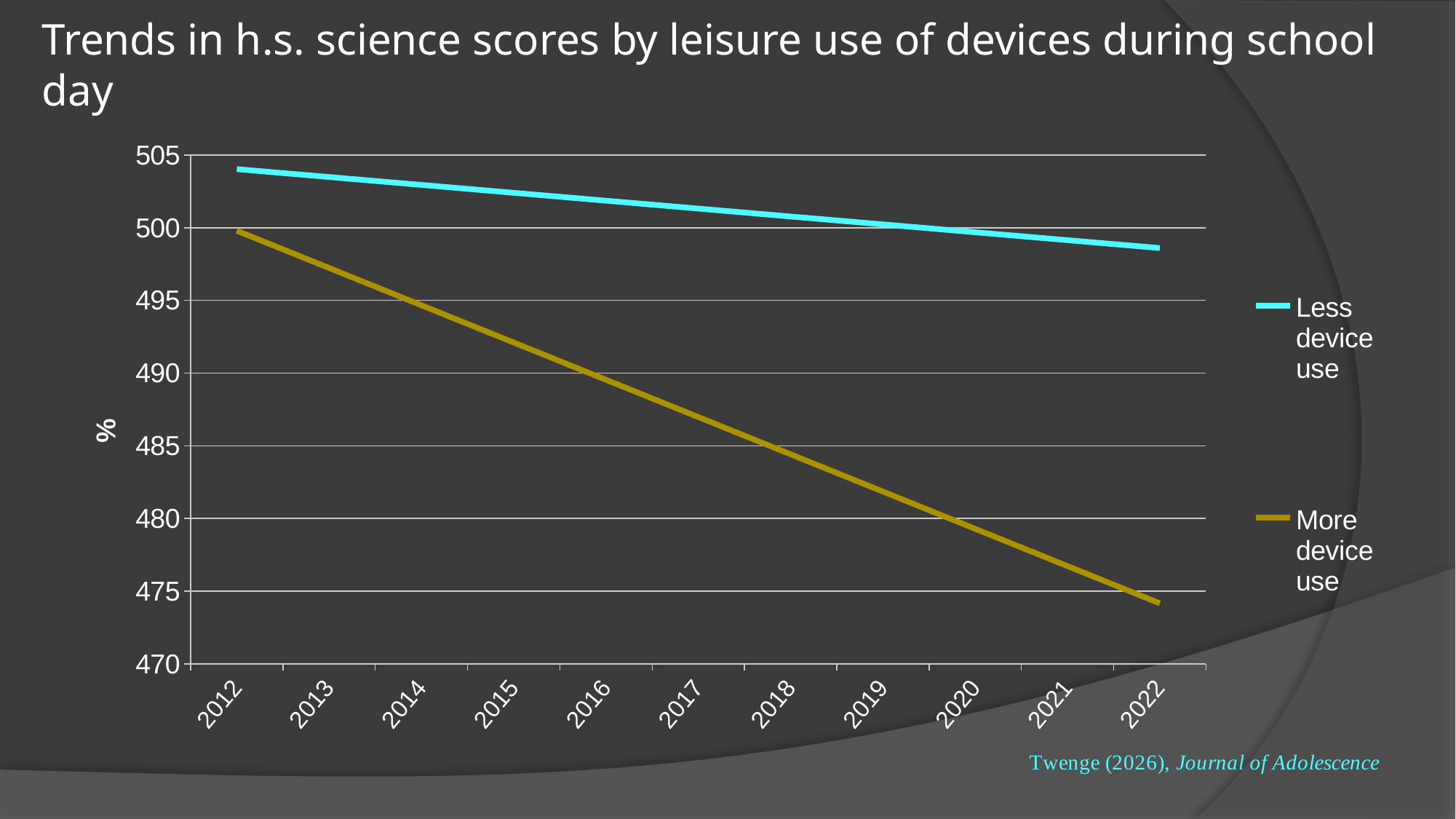
In 2022, which series has the higher value, 'Less device use' or 'More device use'? Less device use Do the values for 'Less device use' rise or fall from 2012 to 2022? fall What is the title of the chart on the slide? Trends in h.s. science scores by leisure use of devices during school day How many series does the legend list? 2 Is the value for 'More device use' in 2016 greater or less than 495? less How many years are shown along the x axis? 11 Is the value for 'Less device use' in 2012 greater or less than 500? greater Do the values for 'More device use' rise or fall from 2012 to 2022? fall Is the value for 'More device use' in 2022 greater or less than 480? less What kind of chart is shown on the slide? line chart What is the label on the y axis of the chart? %